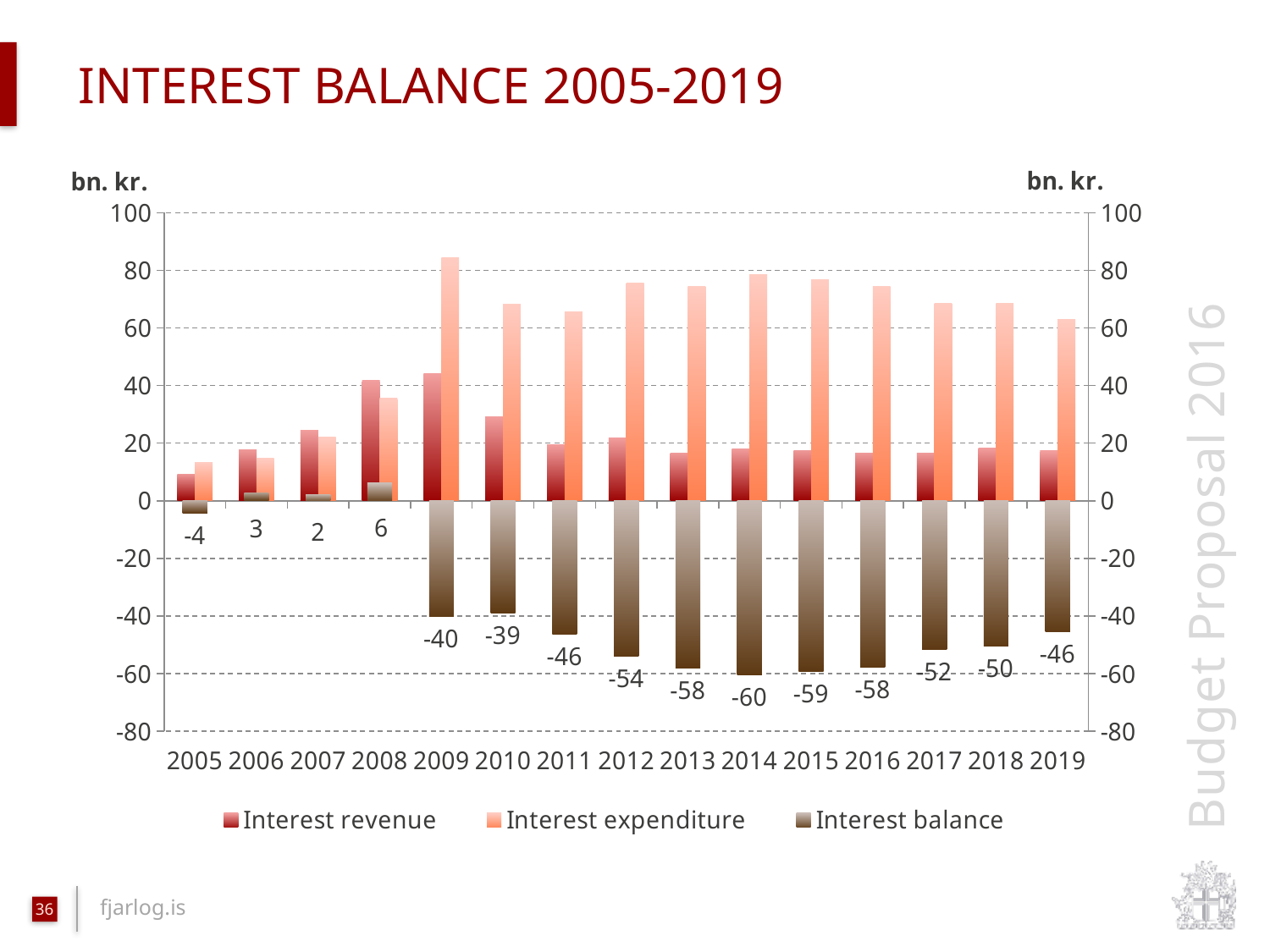
What is the Interest balance value for 2008? 6 How many years are shown on the x axis? 15 Which year has the highest Interest balance? 2008 What is the Interest balance value for 2019? -46 What kind of chart is shown on the slide? Bar chart What is the Interest balance value for 2014? -60 Is the Interest expenditure for 2009 greater or less than 80? greater How many series does the legend list? 3 What is the difference between the Interest balance in 2009 and in 2014? 20 Which year has the lowest Interest balance? 2014 Is the Interest balance larger in 2012 or in 2017? 2017 Is the Interest revenue for 2008 greater or less than 40? greater